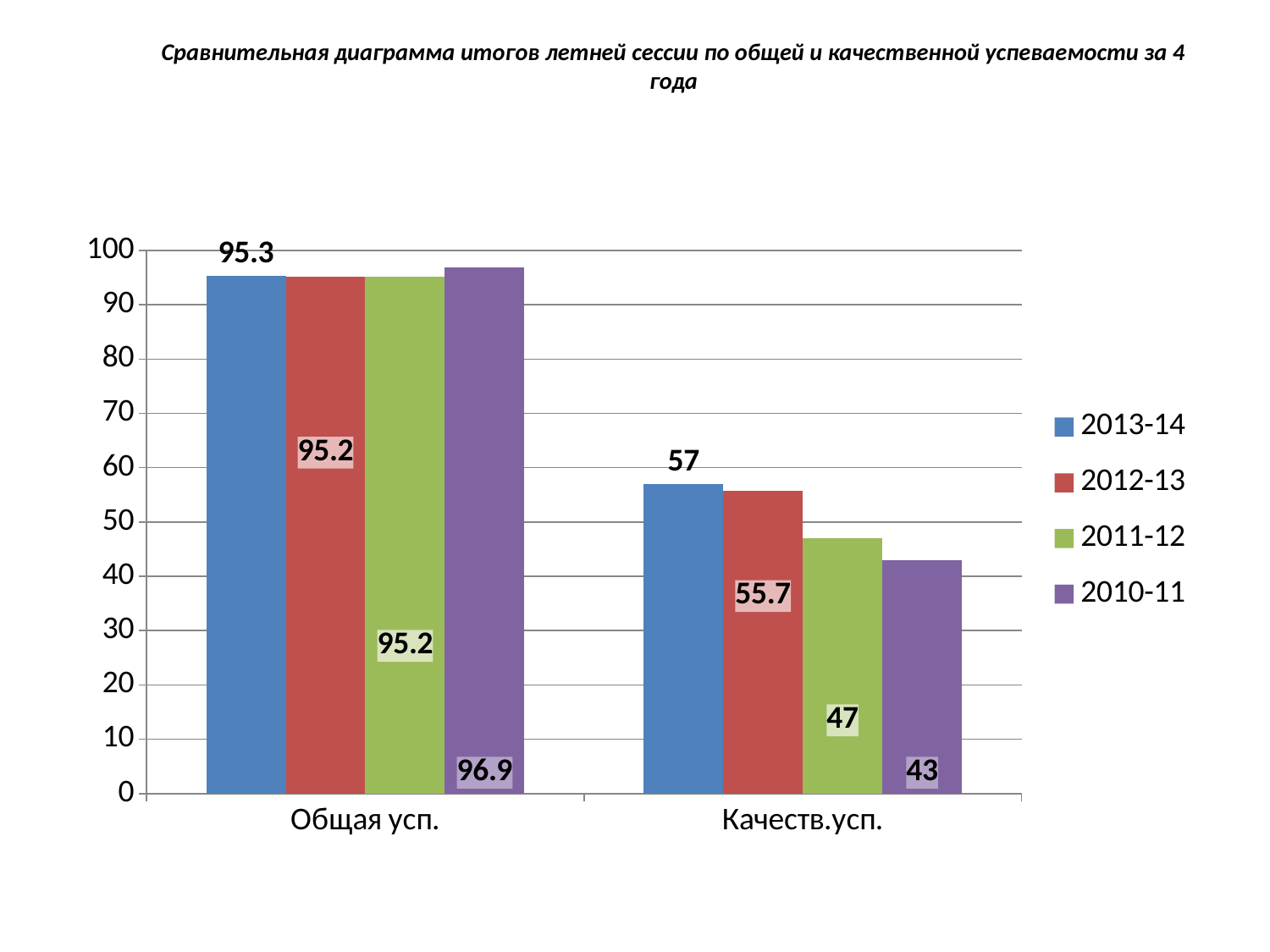
What is the value for 2010-11 in the Общая усп. category? 96.9 What is the value for 2013-14 in the Общая усп. category? 95.3 How many series does the legend list? 4 What is the value for 2012-13 in the Качеств.усп. category? 55.7 Which year has the lowest value in the Качеств.усп. category? 2010-11 Which year has the highest value in the Качеств.усп. category? 2013-14 How many categories are shown on the x axis? 2 What is the value for 2011-12 in the Качеств.усп. category? 47 What kind of chart is shown on the slide? Bar chart What is the difference between the 2013-14 and 2010-11 values in the Качеств.усп. category? 14 In the Качеств.усп. category, which is larger: the value for 2011-12 or the value for 2010-11? 2011-12 What is the difference between the 2010-11 and 2013-14 values in the Общая усп. category? 1.6